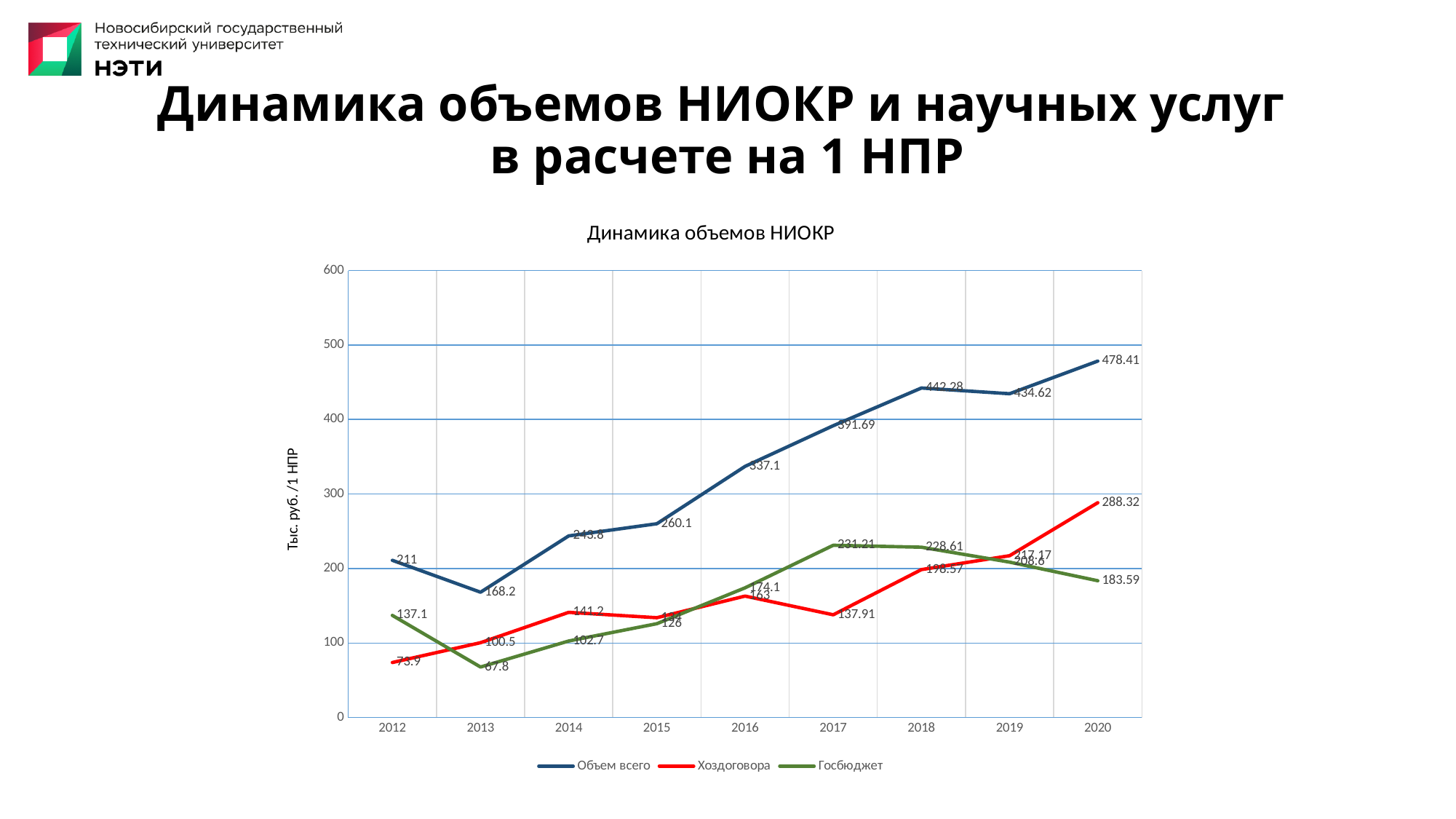
What kind of chart is shown? line chart What is the value of Хоздоговора in 2020? 288.32 In 2017, which is larger: Хоздоговора or Госбюджет? Госбюджет How many years are shown on the x axis? 9 Does Объем всего overall rise or fall from 2012 to 2020? rise How many series does the legend list? 3 What is the value of Объем всего in 2020? 478.41 What is the difference between Объем всего in 2020 and in 2019? 43.79 In which year is Госбюджет lowest? 2013 In which year is Объем всего highest? 2020 What is the value of Госбюджет in 2012? 137.1 Is the value for Объем всего in 2016 greater or less than 300? greater